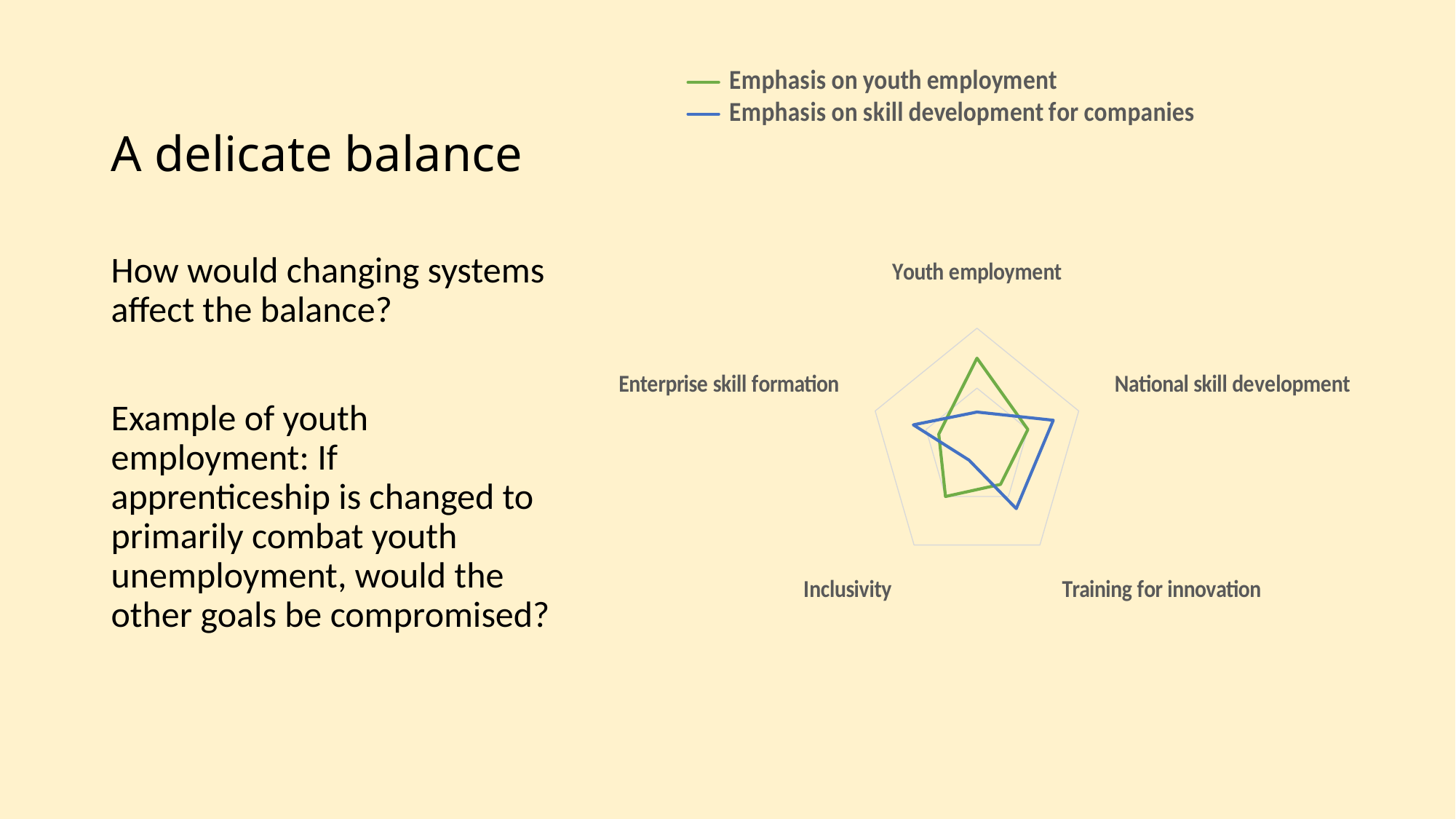
Which series is drawn in blue in the chart? Emphasis on skill development for companies On the Youth employment axis, which series has the larger value: Emphasis on youth employment or Emphasis on skill development for companies? Emphasis on youth employment For the Emphasis on youth employment series, which category has the highest value? Youth employment Which series is drawn in green in the chart? Emphasis on youth employment On the Inclusivity axis, which series has the larger value? Emphasis on youth employment How many series does the chart's legend list? 2 What kind of chart is shown on the slide? Radar chart On the Training for innovation axis, which series has the larger value? Emphasis on skill development for companies For the Emphasis on skill development for companies series, which category has the lowest value? Inclusivity How many categories (axes) does the radar chart have? 5